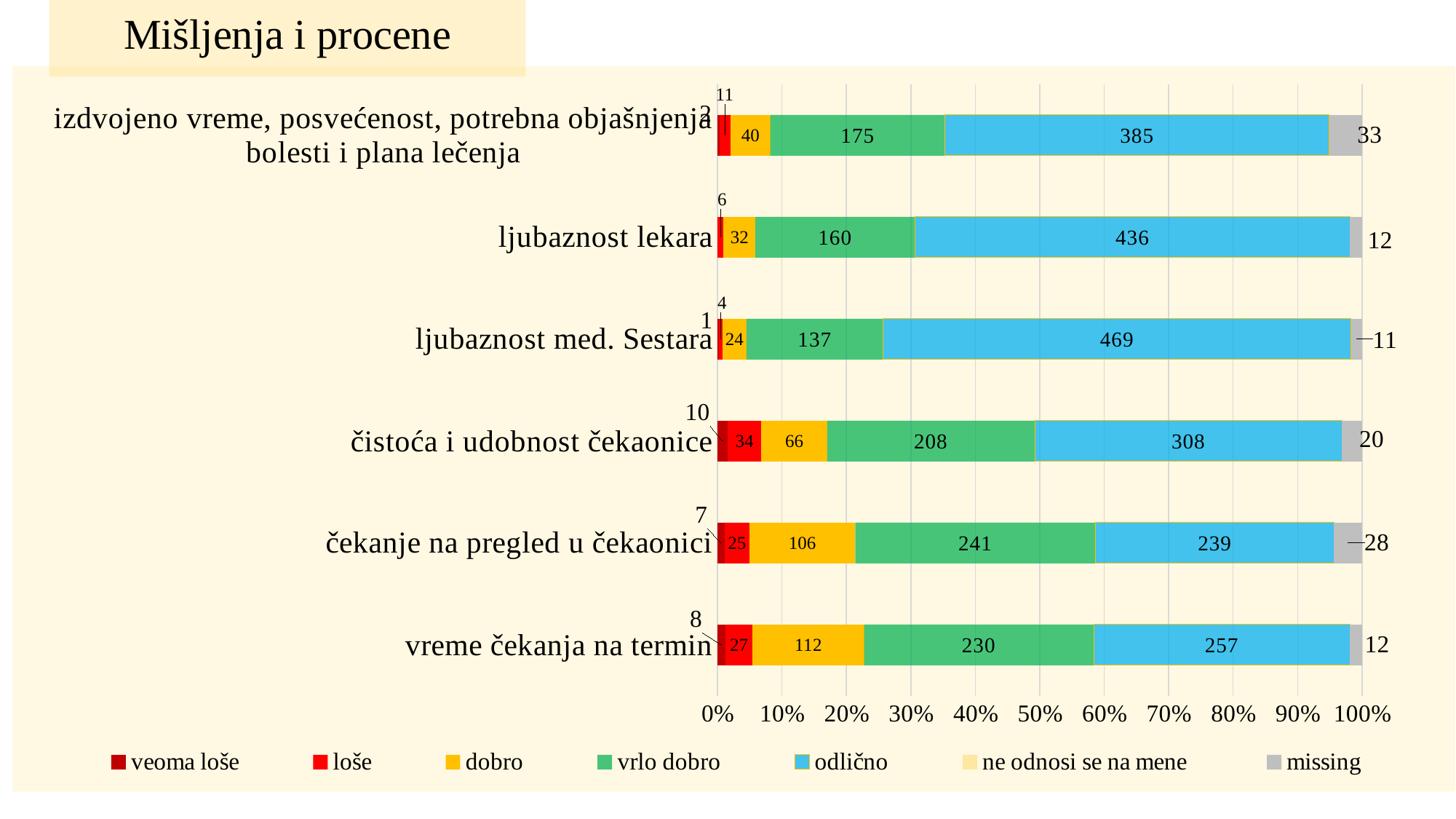
What is the difference between the 'odlično' values for 'ljubaznost med. Sestara' and 'ljubaznost lekara'? 33 What is the title of the slide? Mišljenja i procene Which category has the lowest 'dobro' value? ljubaznost med. Sestara What is the 'missing' value for 'čistoća i udobnost čekaonice'? 20 What kind of chart is shown on the slide? bar chart Which category has the highest 'odlično' value? ljubaznost med. Sestara Which is larger for 'vreme čekanja na termin': the 'vrlo dobro' value or the 'odlično' value? odlično How many categories are shown on the chart? 6 What is the 'vrlo dobro' value for 'čekanje na pregled u čekaonici'? 241 How many series does the legend list? 7 What is the 'odlično' value for 'ljubaznost lekara'? 436 What is the 'dobro' value for 'vreme čekanja na termin'? 112